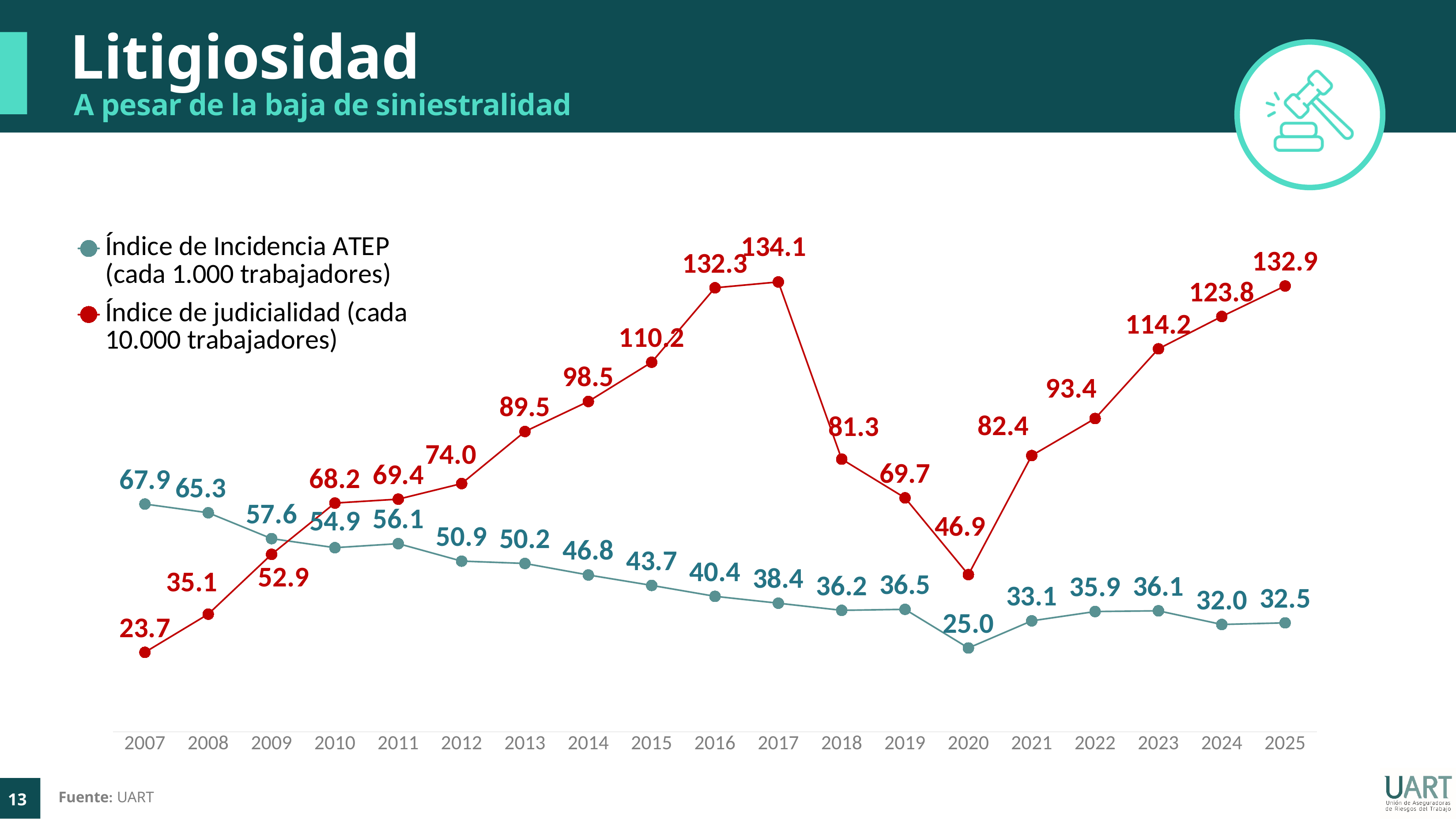
What kind of chart is shown on the slide? Line chart What is the Índice de judicialidad value for 2017? 134.1 How many series does the legend list? 2 In which year is the Índice de Incidencia ATEP at its lowest? 2020 How many years are shown on the x axis? 19 What is the Índice de judicialidad value for 2007? 23.7 In which year is the Índice de judicialidad at its lowest? 2007 In which year does the Índice de judicialidad reach its highest value? 2017 What is the Índice de Incidencia ATEP value for 2020? 25.0 What is the difference between the Índice de judicialidad and the Índice de Incidencia ATEP in 2025? 100.4 Which is larger in 2008: the Índice de Incidencia ATEP or the Índice de judicialidad? Índice de Incidencia ATEP What is the Índice de Incidencia ATEP value for 2025? 32.5